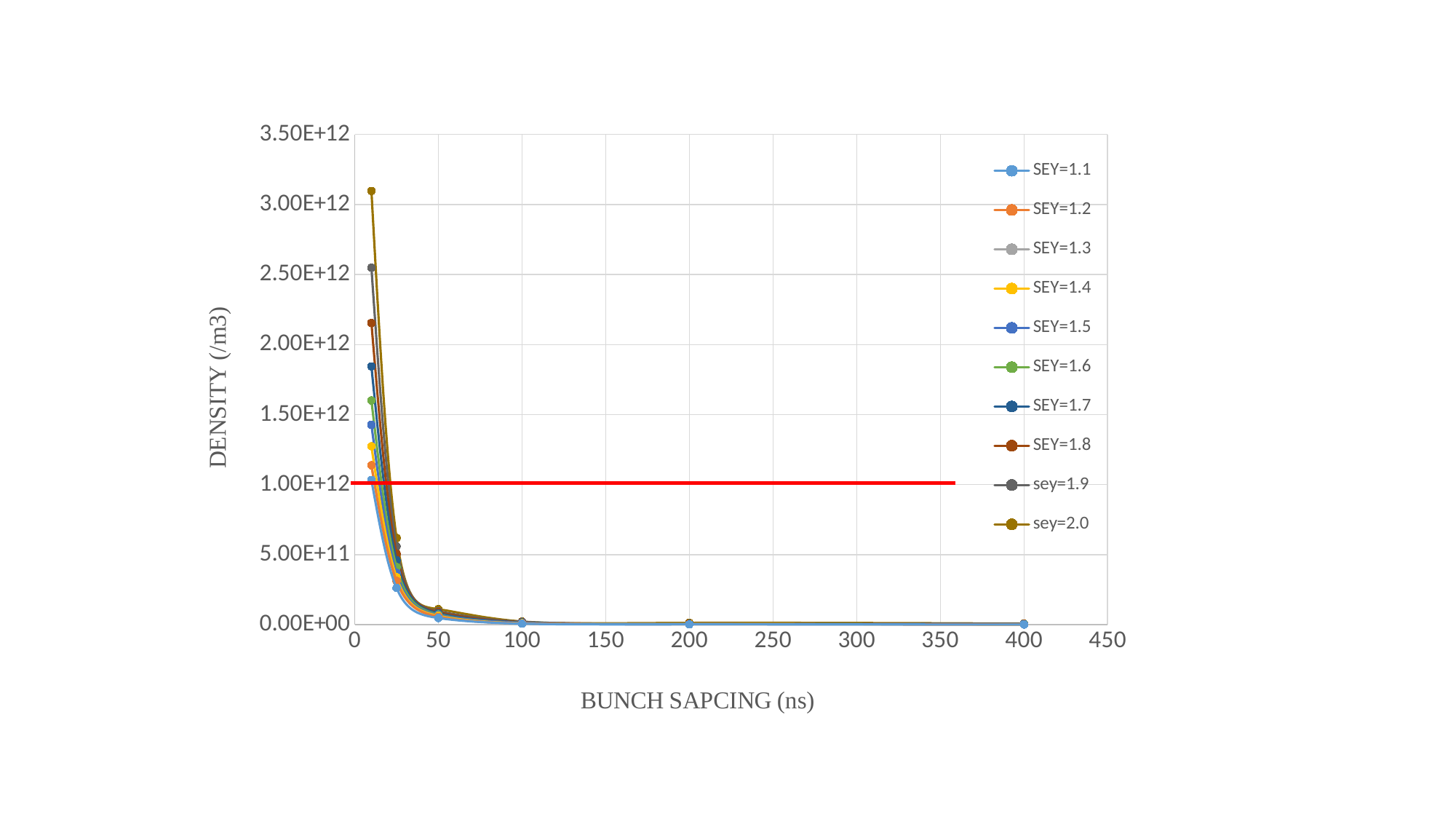
Is the density for sey=2.0 at the smallest bunch spacing greater or less than 2.50E+12? greater At the smallest bunch spacing, which series has the larger density, sey=1.9 or SEY=1.8? sey=1.9 At what density level is the horizontal red line drawn? 1.00E+12 Which series has the lowest density at the smallest bunch spacing? SEY=1.1 At the smallest bunch spacing, which series has the larger density, SEY=1.2 or SEY=1.6? SEY=1.6 Is the density for SEY=1.1 at the smallest bunch spacing greater or less than 1.50E+12? less Do the density values rise or fall as bunch spacing increases? fall Is the density for SEY=1.5 at the smallest bunch spacing greater or less than 1.00E+12? greater How many series does the legend list? 10 What kind of chart is shown on the slide? line chart Which series has the highest density at the smallest bunch spacing? sey=2.0 What is the title of the x axis? BUNCH SAPCING (ns)